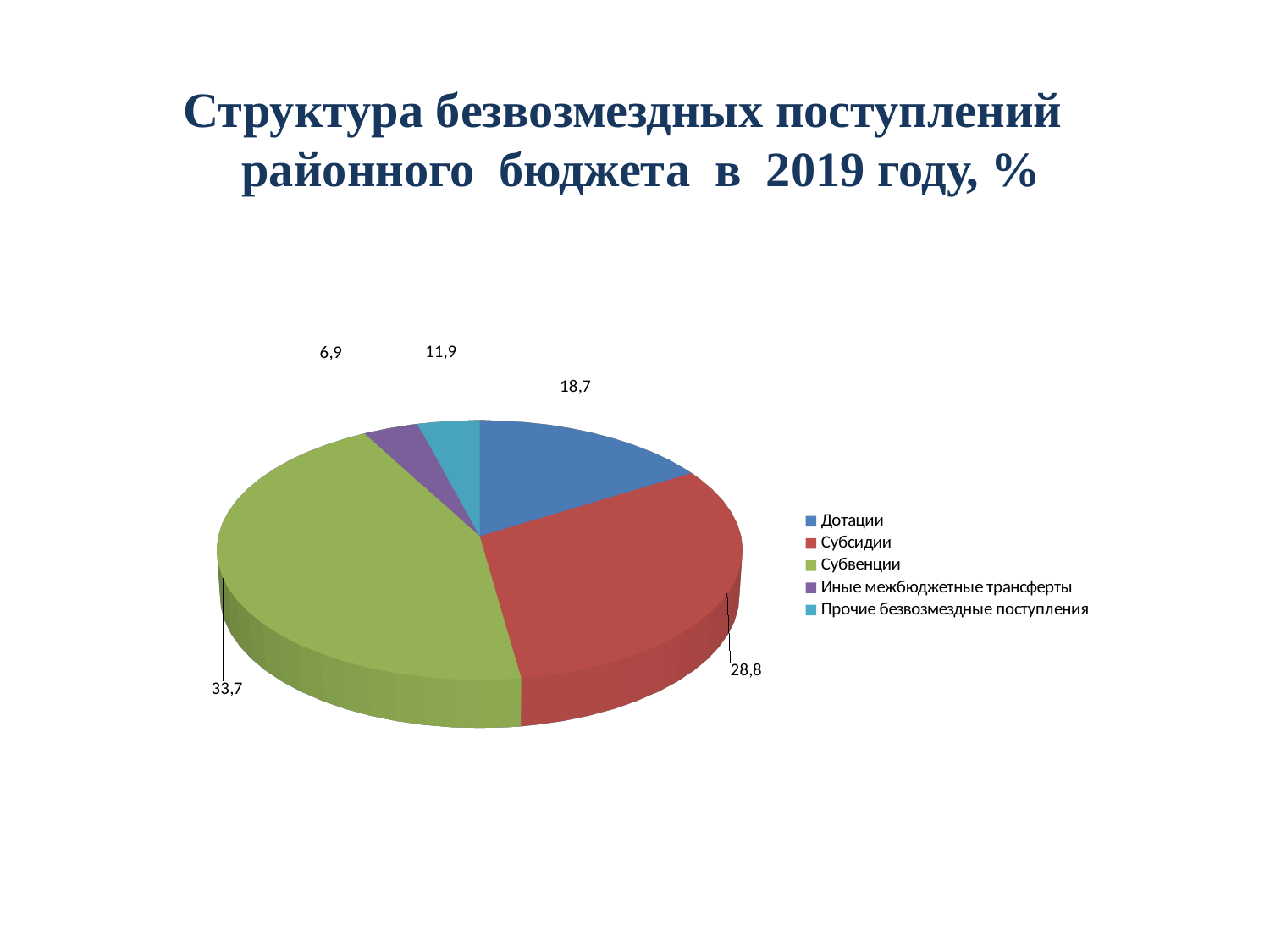
Which category has the largest share of the pie? Субвенции Which category has the smallest share of the pie? Иные межбюджетные трансферты What is the value for Субвенции? 33,7 How many categories does the pie chart have? 5 What is the value for Дотации? 18,7 What is the difference between the values for Субвенции and Субсидии? 4,9 Which colour represents Субсидии in the pie chart? Red Which is larger, the value for Дотации or the value for Прочие безвозмездные поступления? Дотации What is the value for Прочие безвозмездные поступления? 11,9 What type of chart is shown on the slide? Pie chart What is the value for Иные межбюджетные трансферты? 6,9 What is the title of the chart on the slide? Структура безвозмездных поступлений районного бюджета в 2019 году, %